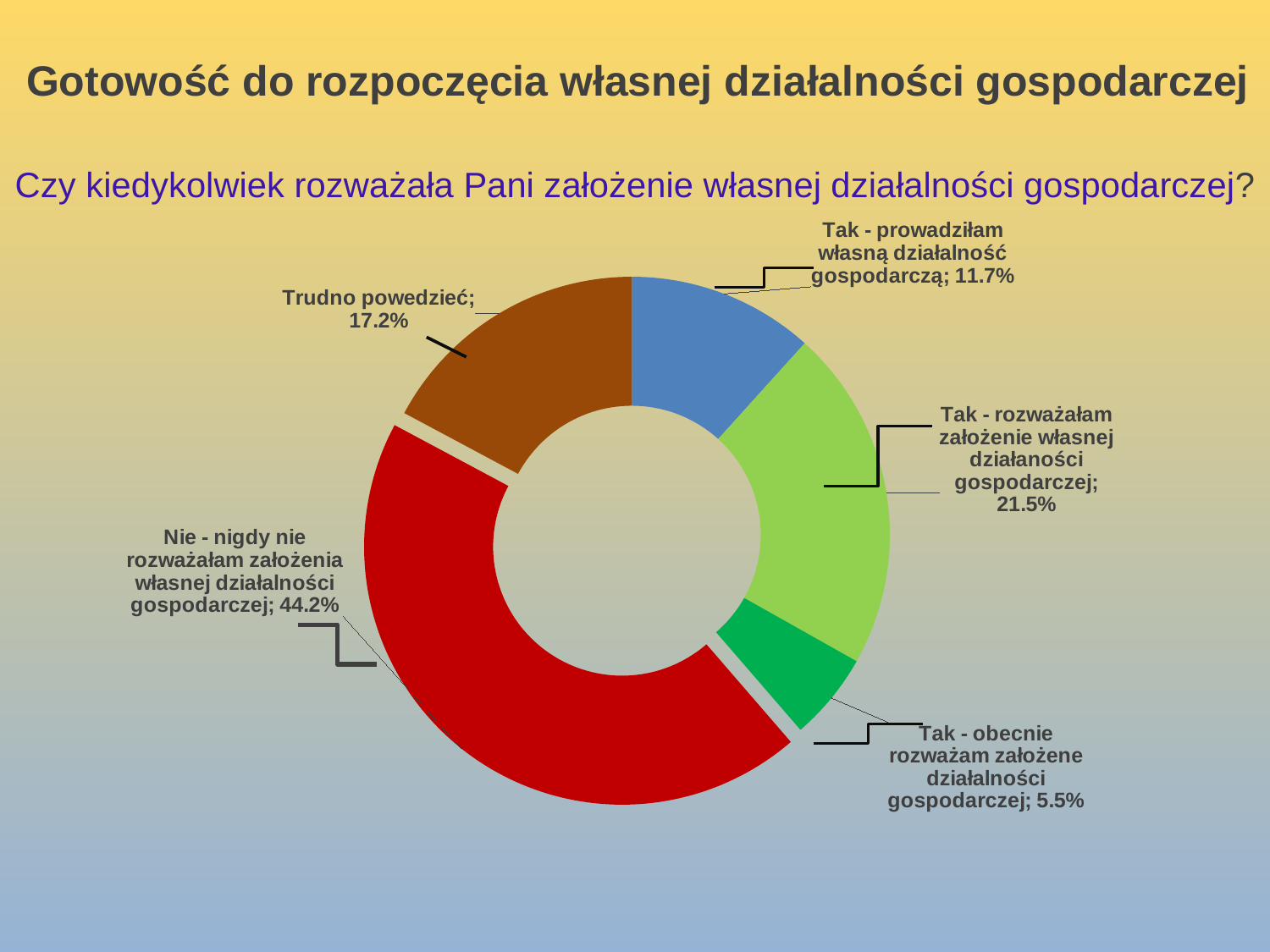
Which category has the smallest share of the chart? Tak - obecnie rozważam założene działalności gospodarczej How many categories are shown in the chart? 5 What is the difference in percentage points between "Tak - rozważałam założenie własnej działaności gospodarczej" and "Tak - prowadziłam własną działalność gospodarczą"? 9.8 What share of respondents answered "Nie - nigdy nie rozważałam założenia własnej działalności gospodarczej"? 44.2% Which is larger: the share for "Trudno powedzieć" or the share for "Tak - rozważałam założenie własnej działaności gospodarczej"? Tak - rozważałam założenie własnej działaności gospodarczej What colour is the slice for "Nie - nigdy nie rozważałam założenia własnej działalności gospodarczej"? Red What is the combined share of the three "Tak" categories? 38.7% What percentage is shown for "Tak - prowadziłam własną działalność gospodarczą"? 11.7% Which category has the largest share of the chart? Nie - nigdy nie rozważałam założenia własnej działalności gospodarczej What percentage is shown for "Trudno powedzieć"? 17.2% What kind of chart is shown on the slide? Doughnut (pie) chart What percentage is shown for "Tak - obecnie rozważam założene działalności gospodarczej"? 5.5%